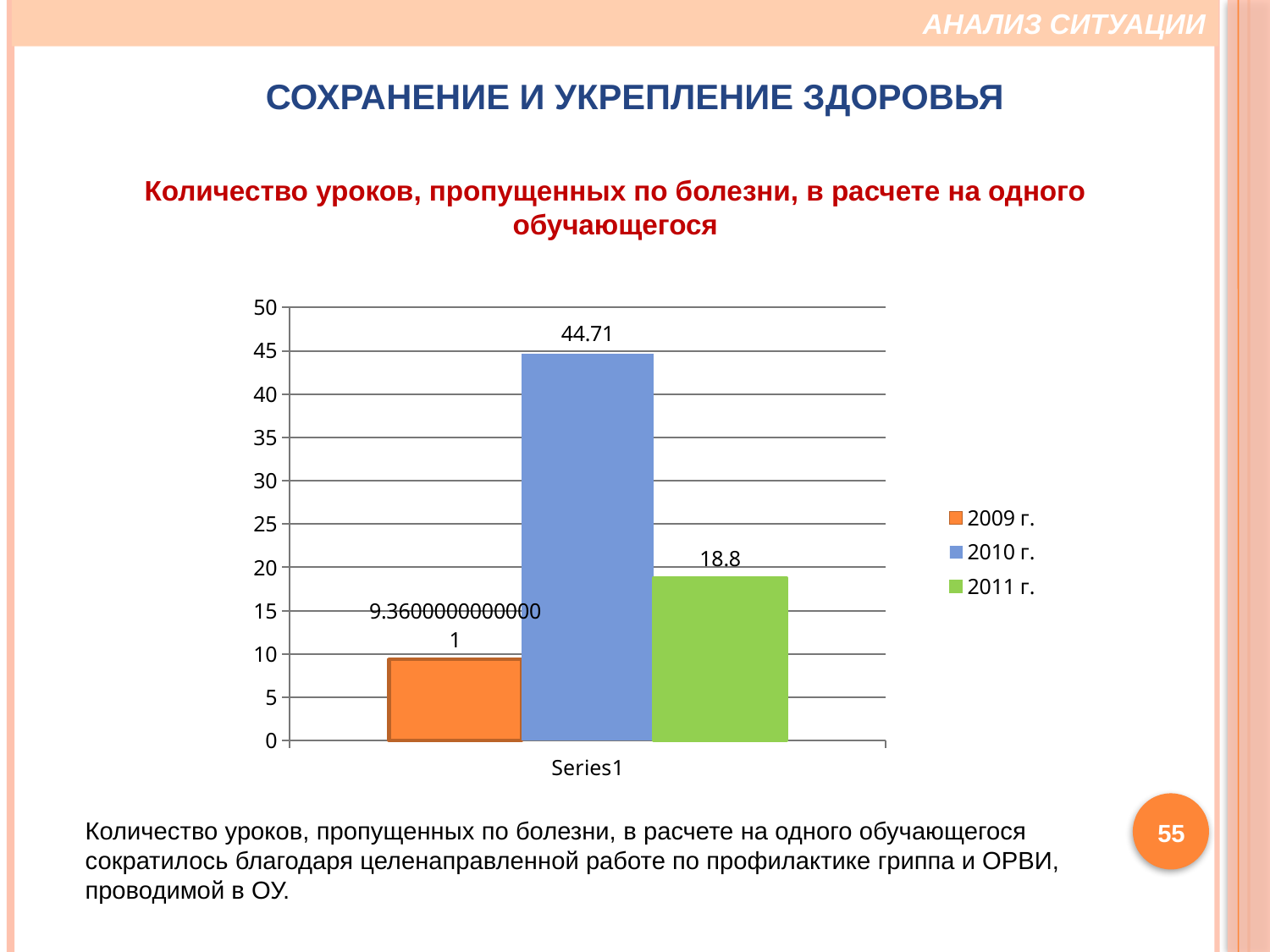
Is the value for 2009 г. greater or less than 10? less Does the value fall or rise from 2010 г. to 2011 г.? fall Which is larger, the value for 2011 г. or the value for 2009 г.? 2011 г. Which year has the highest value in the chart? 2010 г. Is the value for 2010 г. greater or less than 40? greater What is the value for 2011 г. in the chart? 18.8 Which year has the lowest value in the chart? 2009 г. What colour is the bar for 2010 г.? blue How many series does the legend list? 3 What kind of chart is shown on the slide? bar chart What is the value for 2010 г. in the chart? 44.71 What is the difference between the values for 2010 г. and 2011 г.? 25.91